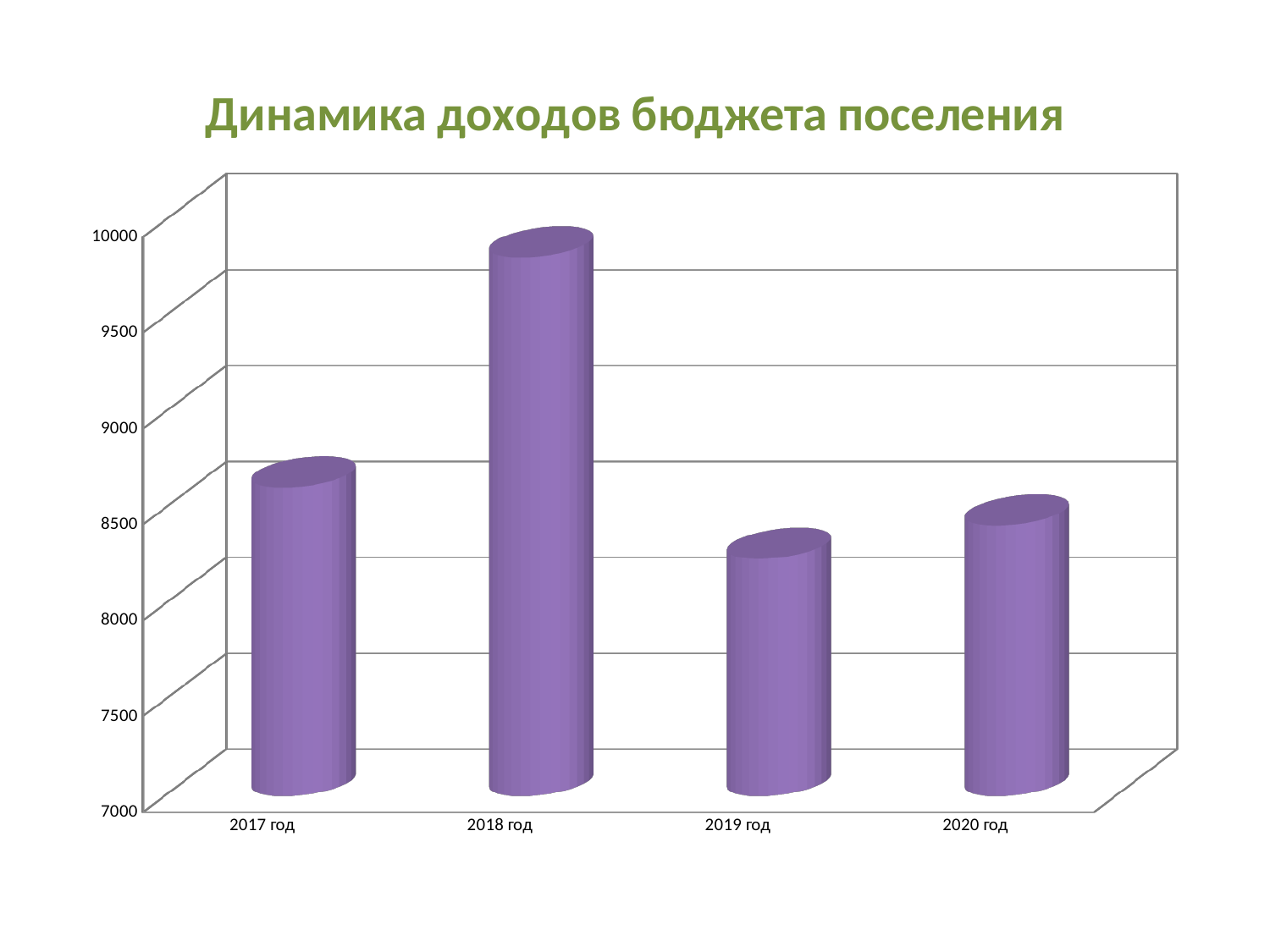
Is the value for 2018 год greater or less than 9500? greater How many categories (years) are shown on the x axis? 4 What kind of chart is shown on the slide? bar chart Does the value rise or fall from 2018 год to 2019 год? fall Which year has the lowest value? 2019 год Which year has the highest value? 2018 год Is the value for 2019 год greater or less than 8500? less What is the lowest value shown on the vertical axis? 7000 Is the value for 2017 год greater or less than 8500? greater Which is larger, the value for 2017 год or the value for 2020 год? 2017 год What is the title of the chart? Динамика доходов бюджета поселения